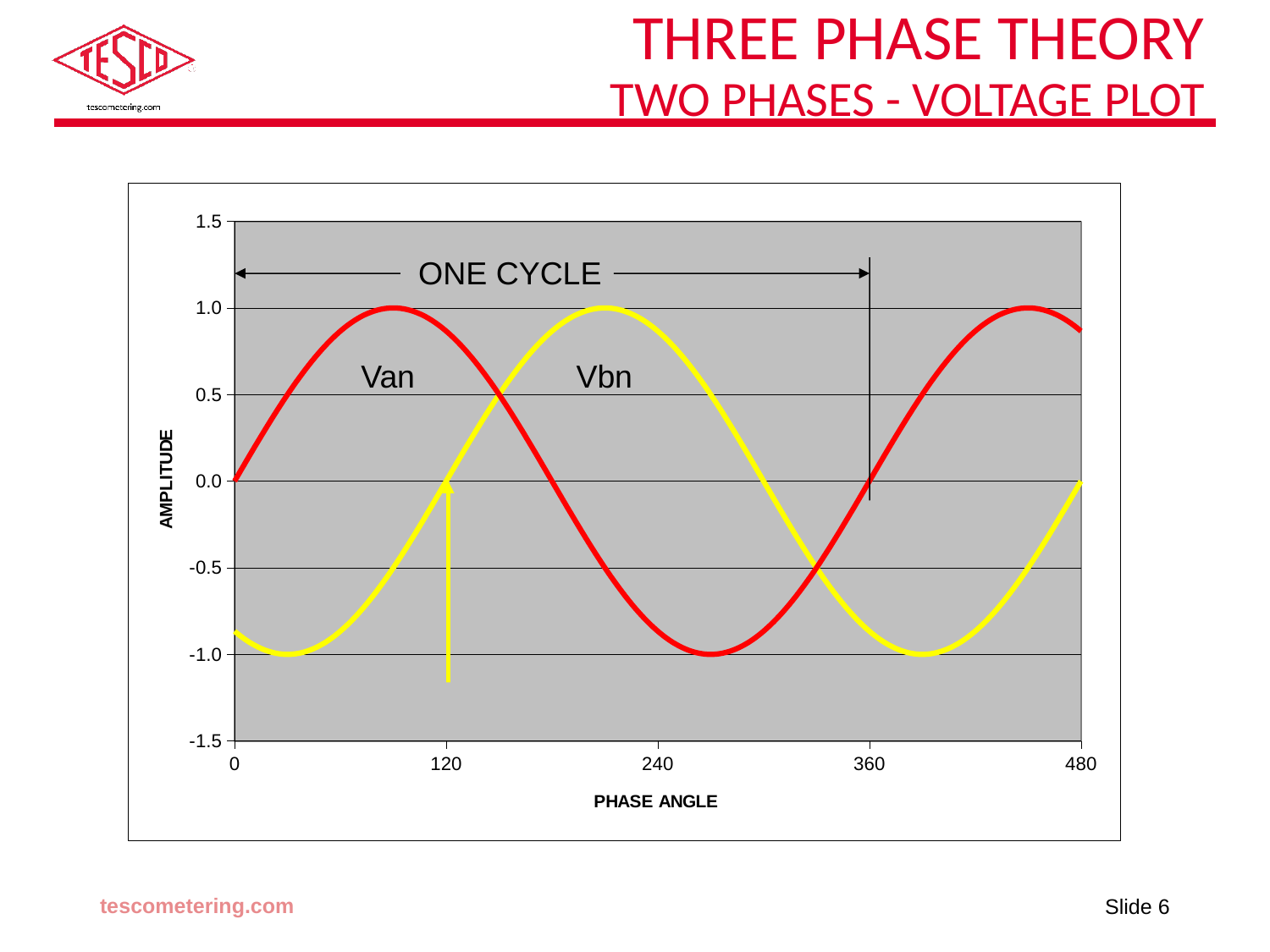
What is the amplitude of Vbn at a phase angle of 120? 0.0 At a phase angle of 60, which waveform has the larger amplitude, Van or Vbn? Van What is the maximum amplitude reached by the Van waveform? 1.0 How many waveforms are plotted on the chart? 2 What is the label of the horizontal axis? PHASE ANGLE Does the Van waveform rise or fall between phase angles 0 and 90? rise What is the amplitude of Van at a phase angle of 0? 0.0 What colour is the Van waveform? red What is the minimum amplitude reached by the Vbn waveform? -1.0 Is the amplitude of Vbn at a phase angle of 0 greater or less than -0.5? less What kind of chart is shown on the slide? line chart What is the amplitude of Van at a phase angle of 360? 0.0